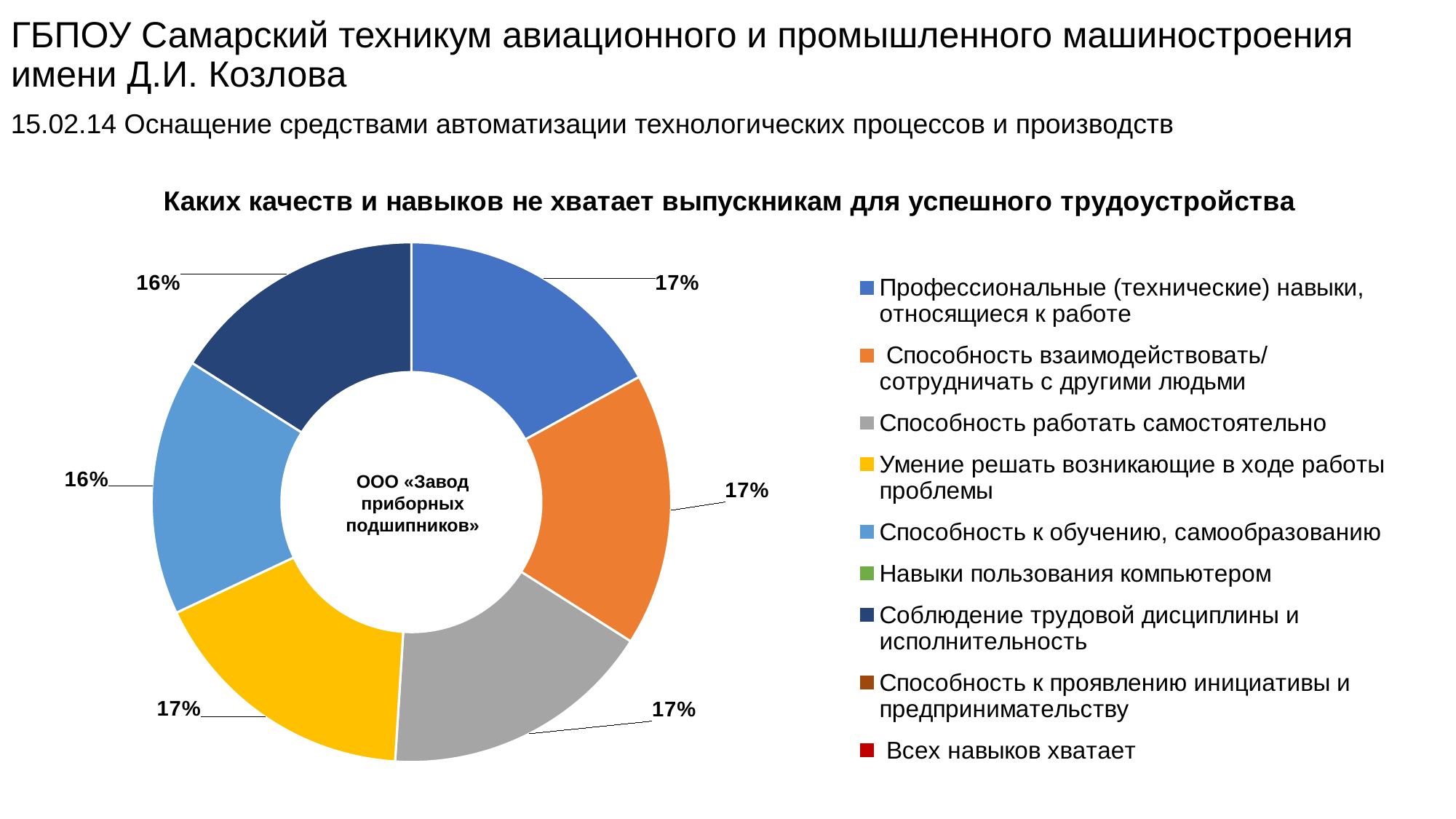
What is the chart's title? Каких качеств и навыков не хватает выпускникам для успешного трудоустройства What text is written in the centre of the doughnut chart? ООО «Завод приборных подшипников» What kind of chart is shown on the slide? doughnut chart What is the difference between the share for «Способность работать самостоятельно» and the share for «Соблюдение трудовой дисциплины и исполнительность»? 1% What share is shown for «Способность к обучению, самообразованию»? 16% What share is shown for «Профессиональные (технические) навыки, относящиеся к работе»? 17% What share is shown for «Соблюдение трудовой дисциплины и исполнительность»? 16% What share is shown for «Способность взаимодействовать/сотрудничать с другими людьми»? 17% Which has the larger share: «Профессиональные (технические) навыки, относящиеся к работе» or «Способность к обучению, самообразованию»? Профессиональные (технические) навыки, относящиеся к работе What share is shown for «Умение решать возникающие в ходе работы проблемы»? 17% What share is shown for «Способность работать самостоятельно»? 17% How many entries does the legend list? 9